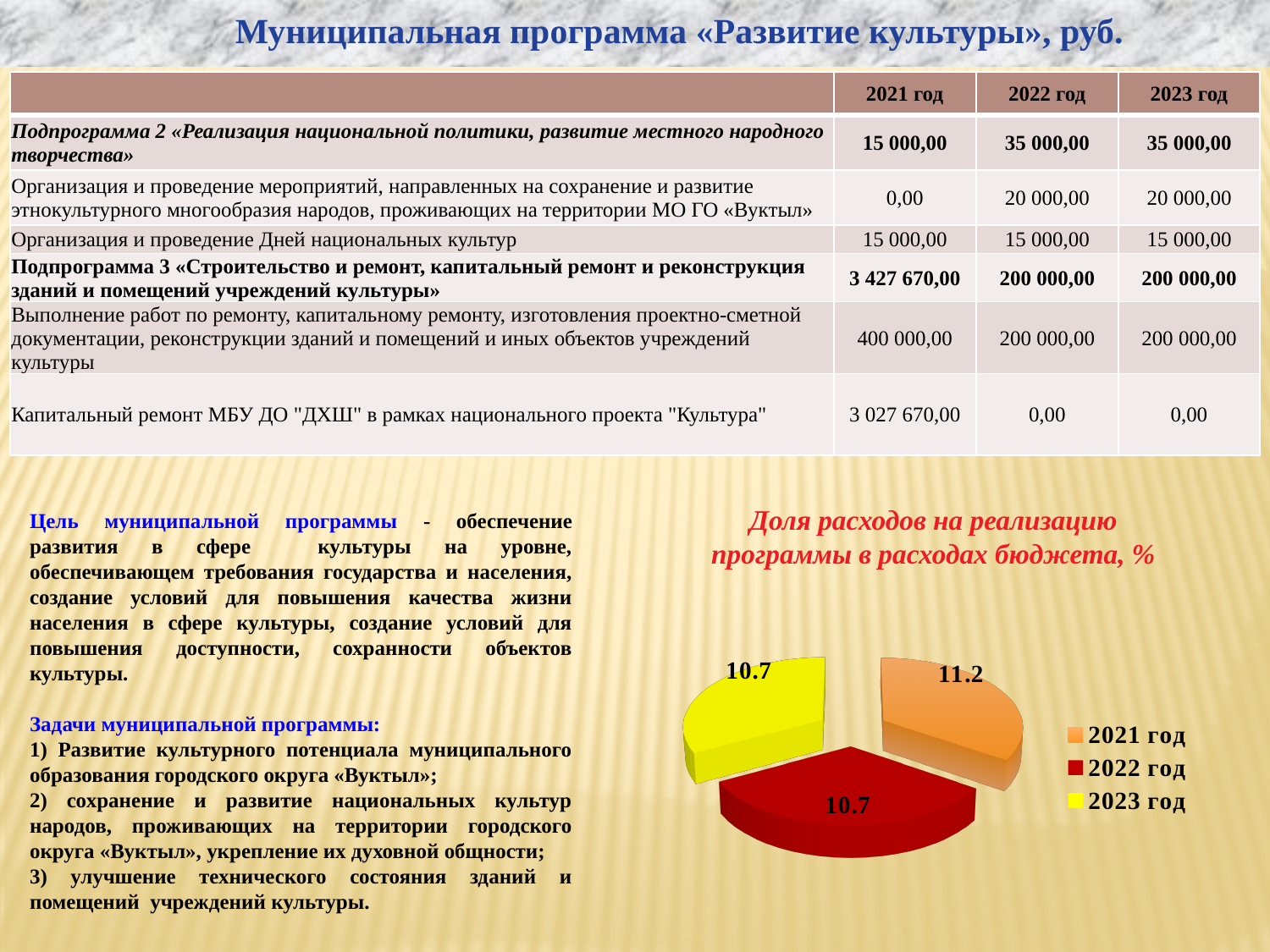
What is the value shown for 2022 год in the pie chart? 10.7 What kind of chart is shown on the slide? Pie chart Which is larger in the pie chart, the value for 2021 год or the value for 2023 год? 2021 год How many entries does the legend of the pie chart list? 3 What is the difference between the values for 2021 год and 2022 год in the pie chart? 0.5 What is the value shown for 2023 год in the pie chart? 10.7 How many slices does the pie chart have? 3 Which year has the highest value in the pie chart? 2021 год Which year is represented by the yellow slice in the pie chart? 2023 год What is the title of the chart on the slide? Доля расходов на реализацию программы в расходах бюджета, % What is the value shown for 2021 год in the pie chart? 11.2